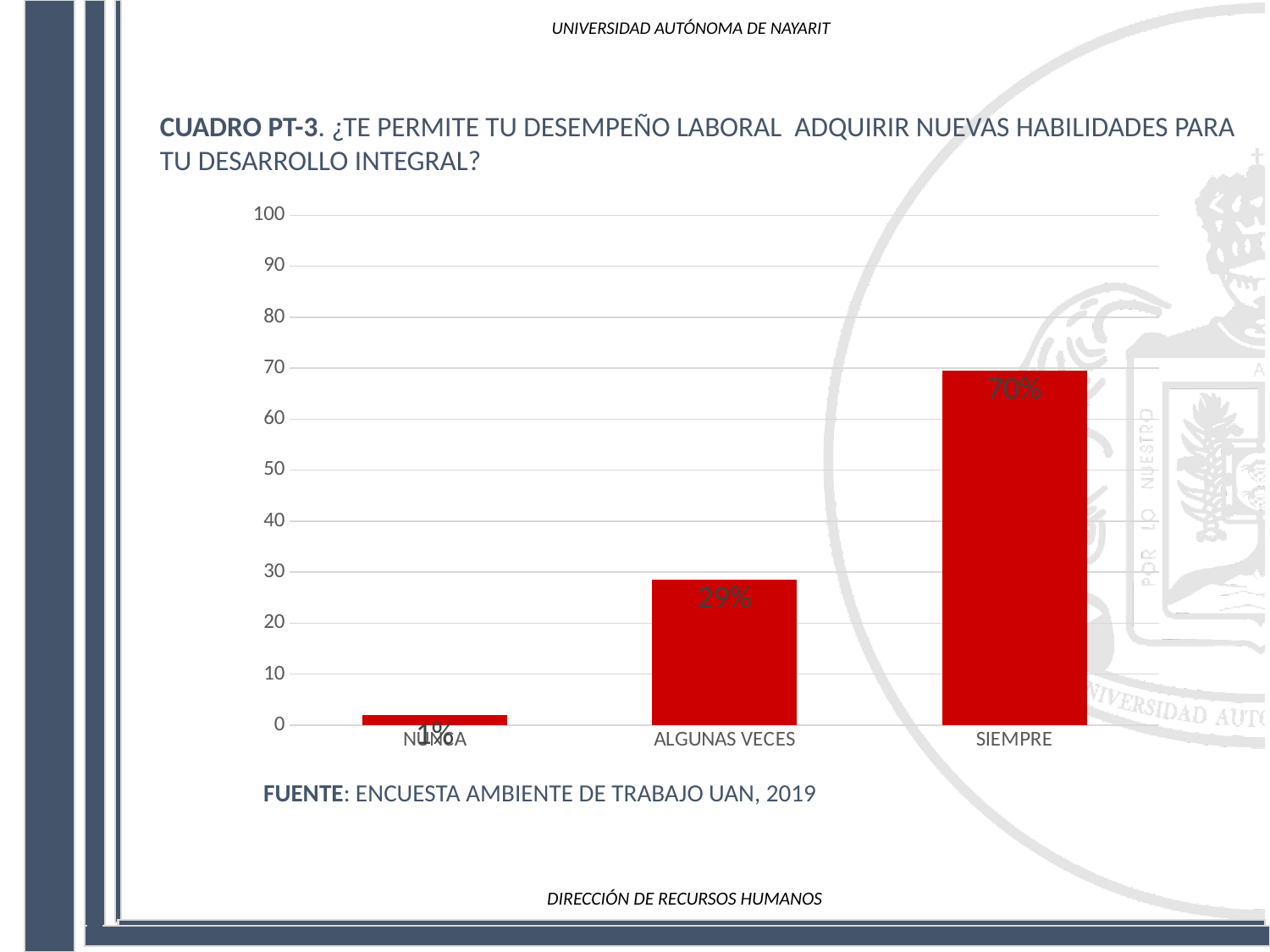
What is the value for ALGUNAS VECES? 29% What is the value for NUNCA? 1% What is the difference between the values for SIEMPRE and ALGUNAS VECES? 41% Is the value for ALGUNAS VECES greater or less than 40? less Do the values rise or fall from left to right along the x axis? rise How many categories are shown on the x axis? 3 Which category has the lowest value? NUNCA What is the value for SIEMPRE? 70% What kind of chart is shown on the slide? bar chart Which is larger, the value for ALGUNAS VECES or the value for NUNCA? ALGUNAS VECES What source is cited below the chart? ENCUESTA AMBIENTE DE TRABAJO UAN, 2019 Which category has the highest value? SIEMPRE